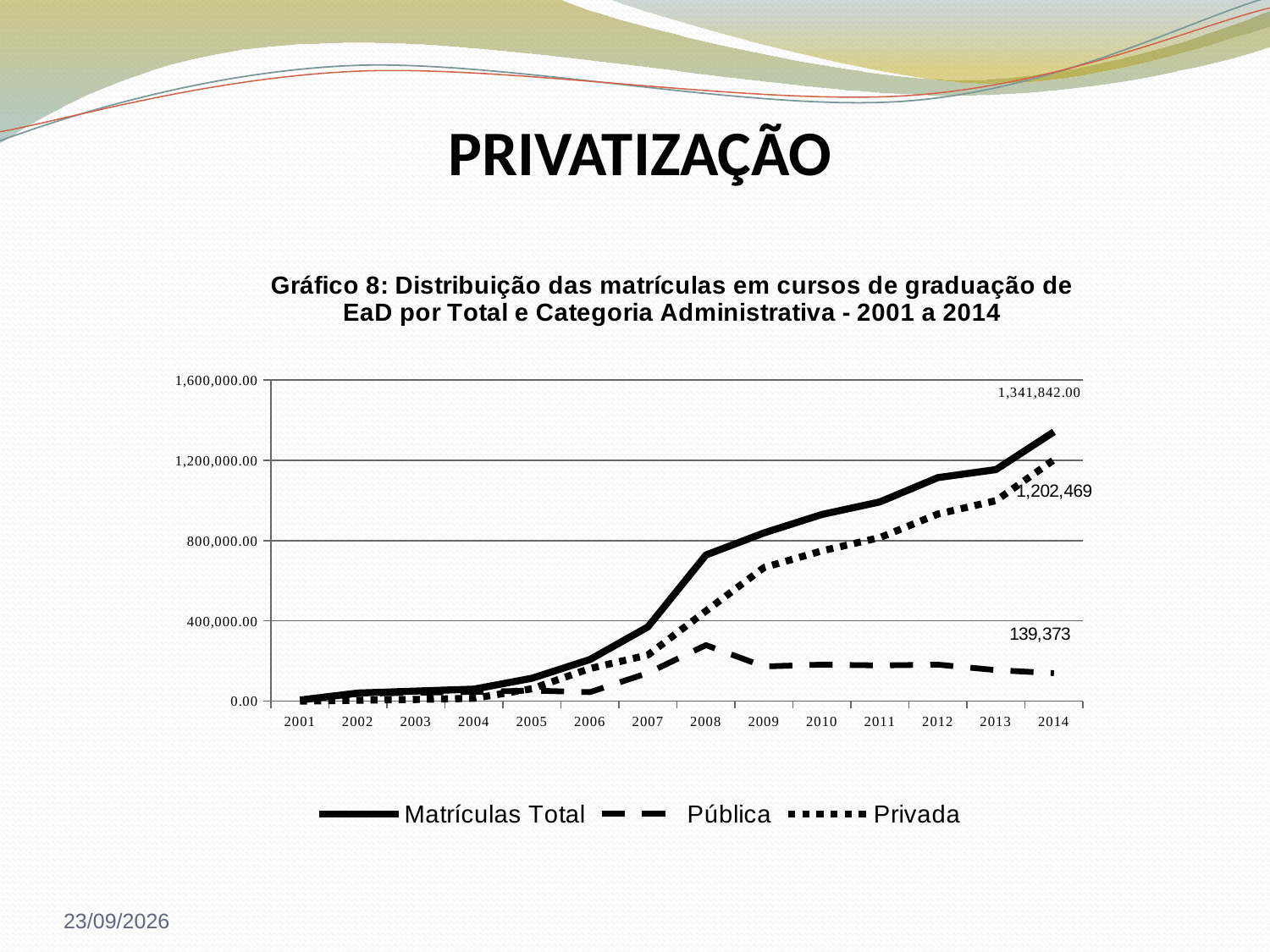
In 2014, which is larger: Privada or Pública? Privada How many years are shown on the x axis? 14 What is the value of the Pública series in 2014? 139,373 What is the value of Matrículas Total in 2014? 1,341,842.00 What is the value of the Privada series in 2014? 1,202,469 How many series does the legend list? 3 What kind of chart is shown on the slide? Line chart Which series has the lowest value in 2014? Pública Is the value for Pública in 2010 greater or less than 400,000.00? less Is the value for Matrículas Total in 2010 greater or less than 800,000.00? greater Which series has the highest value in 2014? Matrículas Total What is the difference between the Privada and Pública values in 2014? 1,063,096